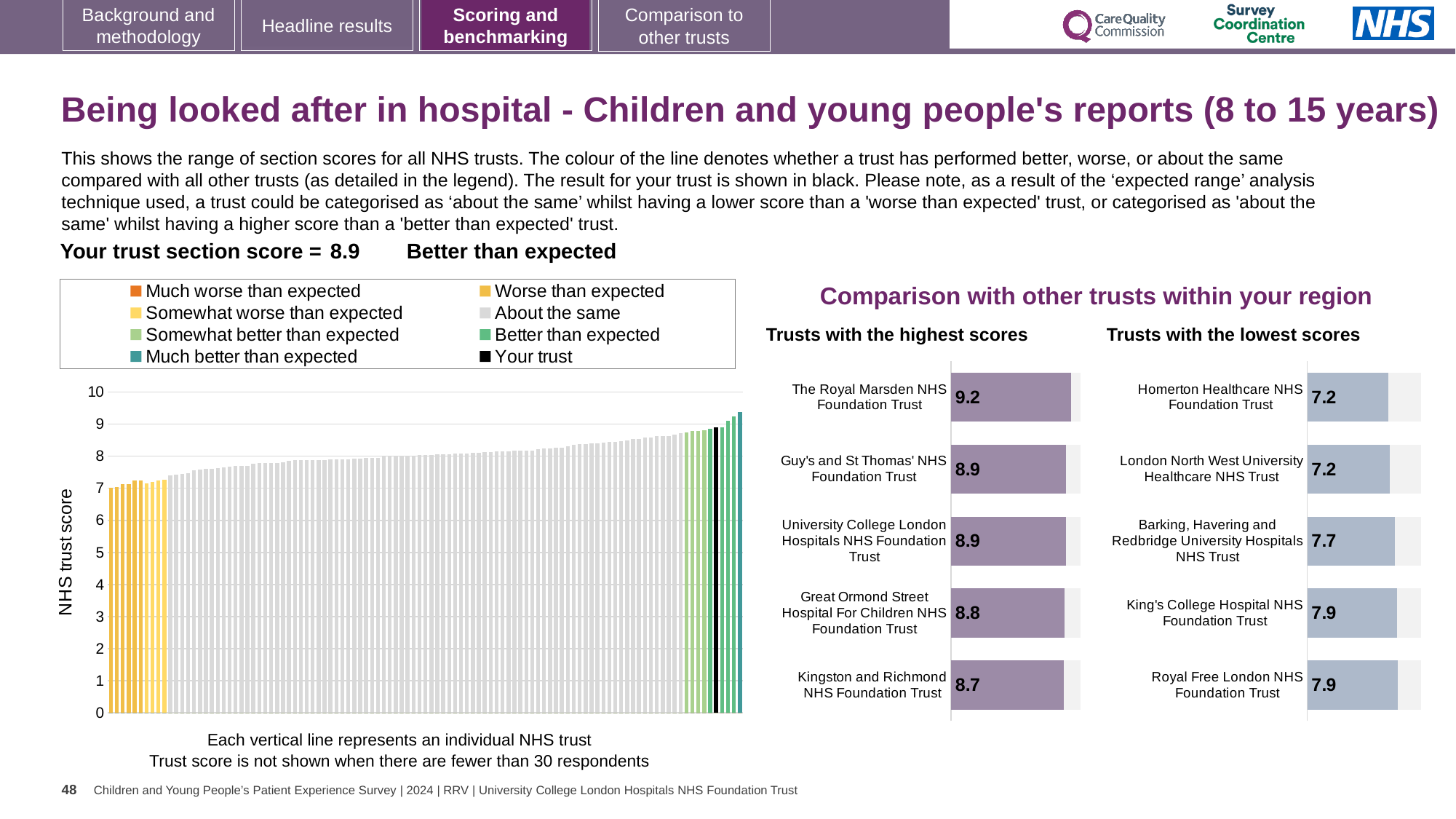
In the 'Trusts with the lowest scores' chart, what is the score for Homerton Healthcare NHS Foundation Trust? 7.2 In the 'Trusts with the highest scores' chart, which has the larger score: Great Ormond Street Hospital For Children NHS Foundation Trust or Kingston and Richmond NHS Foundation Trust? Great Ormond Street Hospital For Children NHS Foundation Trust In the 'Trusts with the highest scores' chart, what is the difference between the scores of The Royal Marsden NHS Foundation Trust and Kingston and Richmond NHS Foundation Trust? 0.5 What kind of chart is the large chart on the left showing NHS trust scores? Bar chart In the left-hand chart, do the trust scores rise or fall from left to right? Rise In the 'Trusts with the highest scores' chart, what is the score for Kingston and Richmond NHS Foundation Trust? 8.7 How many entries does the legend of the left-hand chart list? 8 In the 'Trusts with the highest scores' chart, which trust has the highest score? The Royal Marsden NHS Foundation Trust How many trusts are shown in the 'Trusts with the highest scores' chart? 5 In the 'Trusts with the highest scores' chart, what is the score for The Royal Marsden NHS Foundation Trust? 9.2 In the 'Trusts with the lowest scores' chart, what is the difference between the scores of Royal Free London NHS Foundation Trust and Homerton Healthcare NHS Foundation Trust? 0.7 In the 'Trusts with the lowest scores' chart, what is the score for Barking, Havering and Redbridge University Hospitals NHS Trust? 7.7